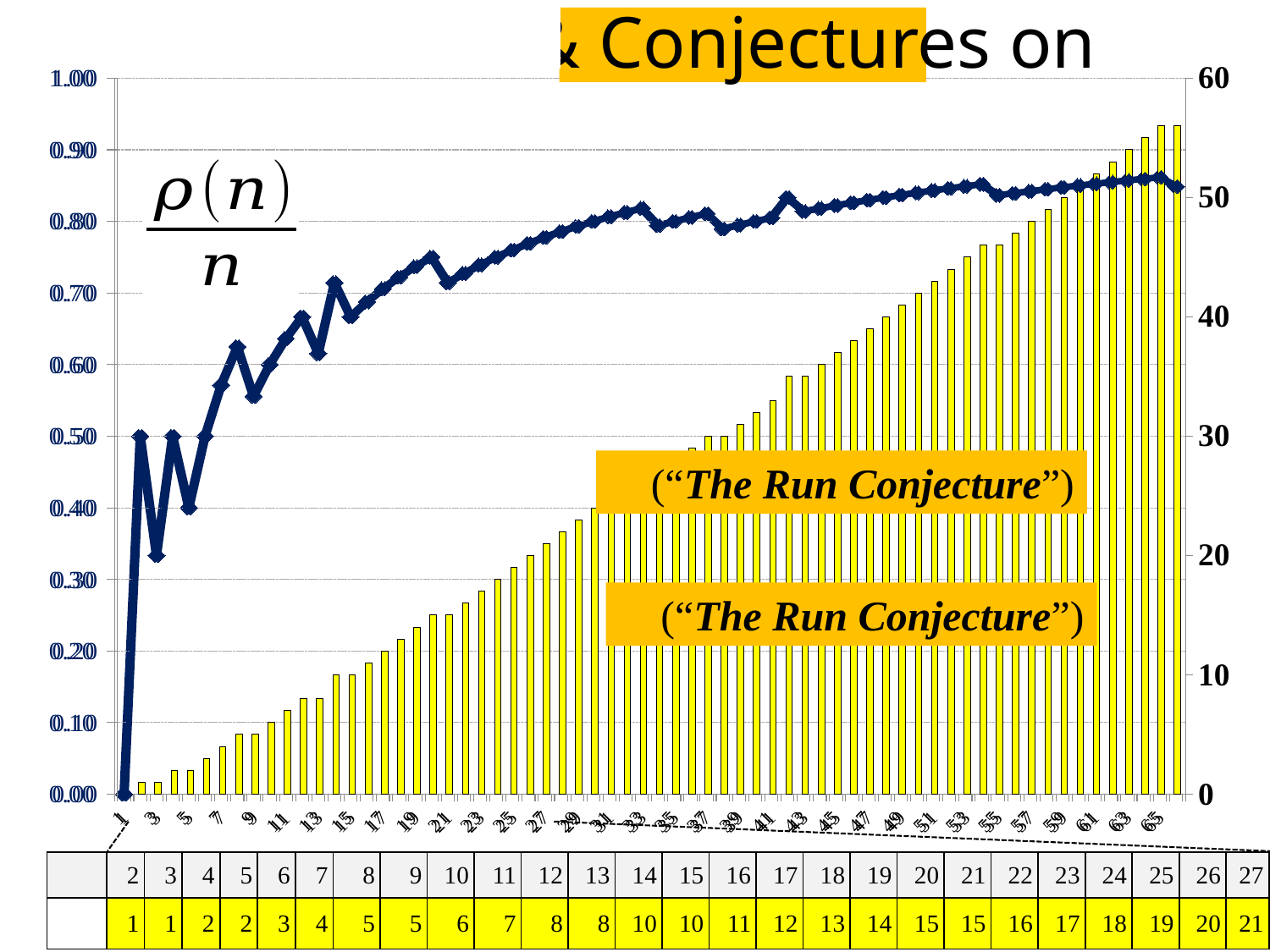
Do the yellow bars generally rise or fall as x increases? rise Is the blue line's value at x = 65 greater or less than 0.80? greater What is the value of the blue line at x = 2? 0.50 Is the yellow bar at x = 9 greater or less than 10 on the right axis? less Is the yellow bar at x = 65 greater or less than 50 on the right axis? greater What kind of chart is shown on the slide? A combination bar and line chart What is the value of the blue line at x = 5? 0.40 What is the value of the blue line at x = 1? 0.00 What is the difference between the blue line's values at x = 2 and x = 5? 0.10 What is the maximum value shown on the right-hand axis? 60 At which x value is the blue line lowest? 1 Which is larger, the blue line's value at x = 2 or at x = 3? x = 2